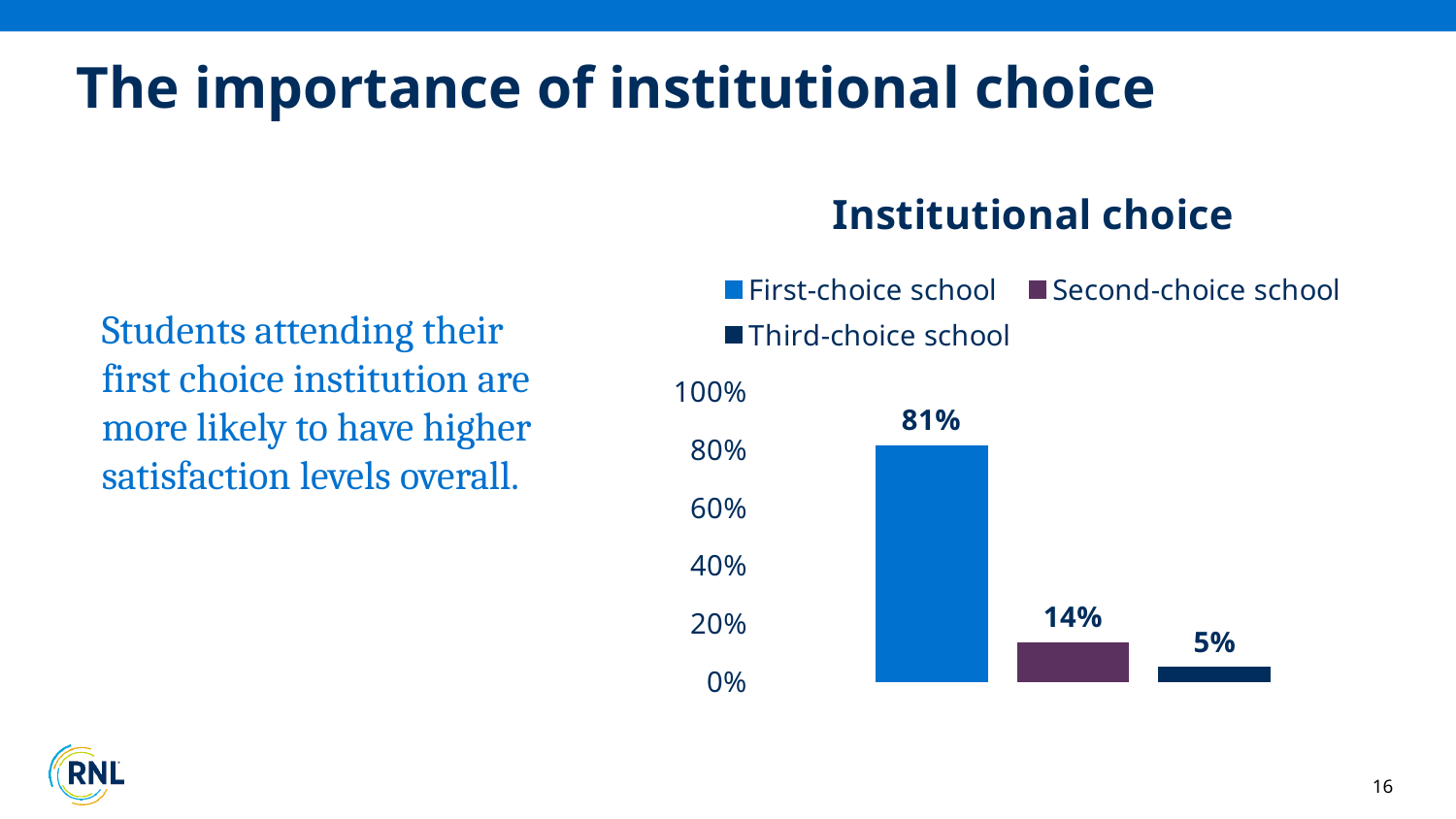
Which is larger, the value for Second-choice school or Third-choice school? Second-choice school Which series has the lowest value? Third-choice school What is the value for First-choice school? 81% What is the difference between the First-choice school and Second-choice school values? 67% What is the value for Second-choice school? 14% What is the value for Third-choice school? 5% Is the value for First-choice school greater or less than 60%? greater What is the title of the chart? Institutional choice What kind of chart is shown on the slide? bar chart Which series has the highest value? First-choice school How many series does the legend list? 3 What is the difference between the Second-choice school and Third-choice school values? 9%